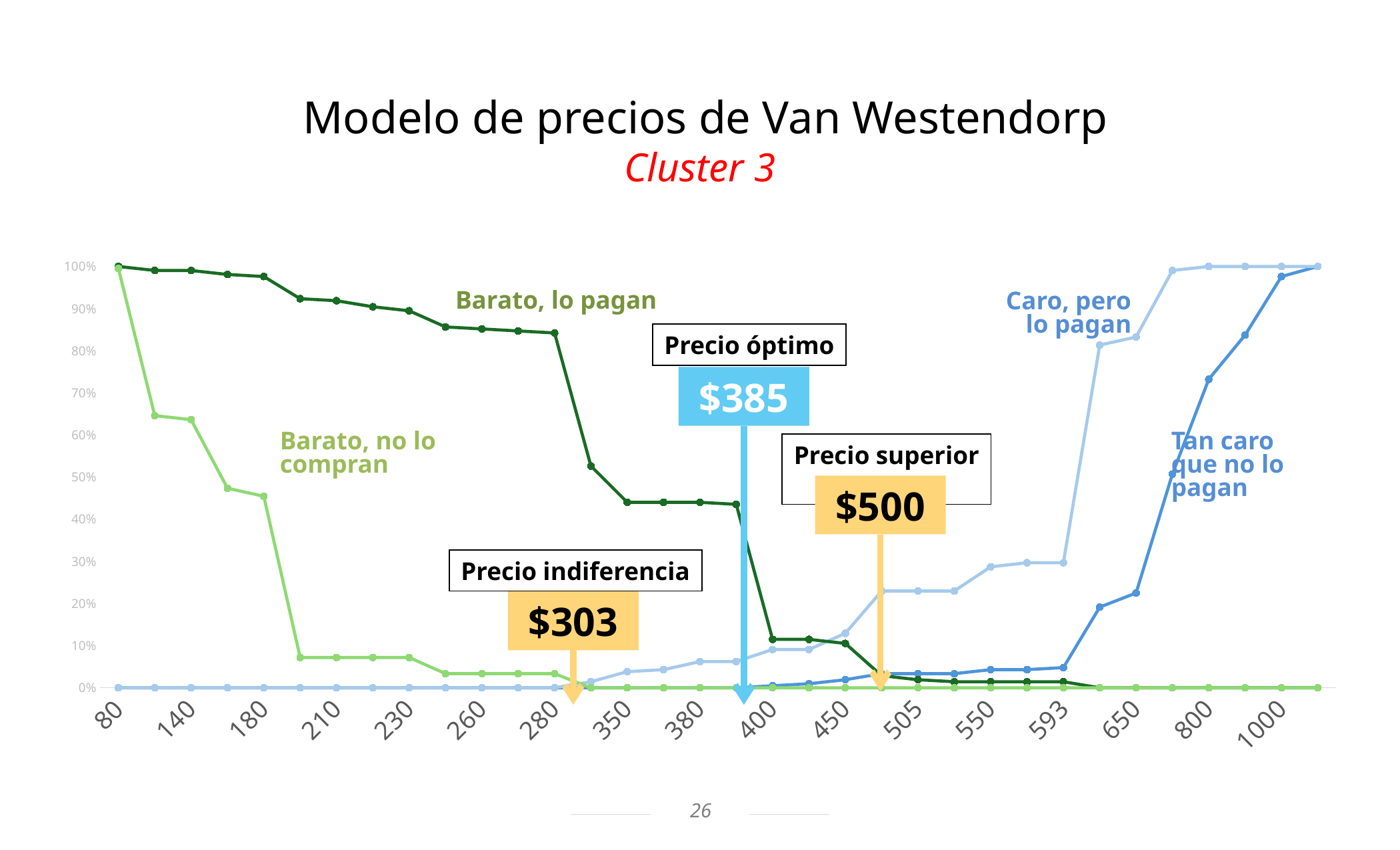
What is the 'Precio superior' shown on the chart? $500 Does the 'Tan caro que no lo pagan' series rise or fall as the price increases along the x axis? rise What is the value of 'Barato, lo pagan' at the price 80? 100% Is the value of 'Caro, pero lo pagan' at the price 550 greater or less than 40%? less What is the title of the chart on the slide? Modelo de precios de Van Westendorp What is the 'Precio indiferencia' shown on the chart? $303 What is the 'Precio óptimo' shown on the chart? $385 How many price points are labelled on the x axis? 17 Which cluster does the chart refer to? Cluster 3 What kind of chart is shown on the slide? line chart Is the value of 'Barato, lo pagan' at the price 280 greater or less than 80%? greater How many series are plotted on the chart? 4